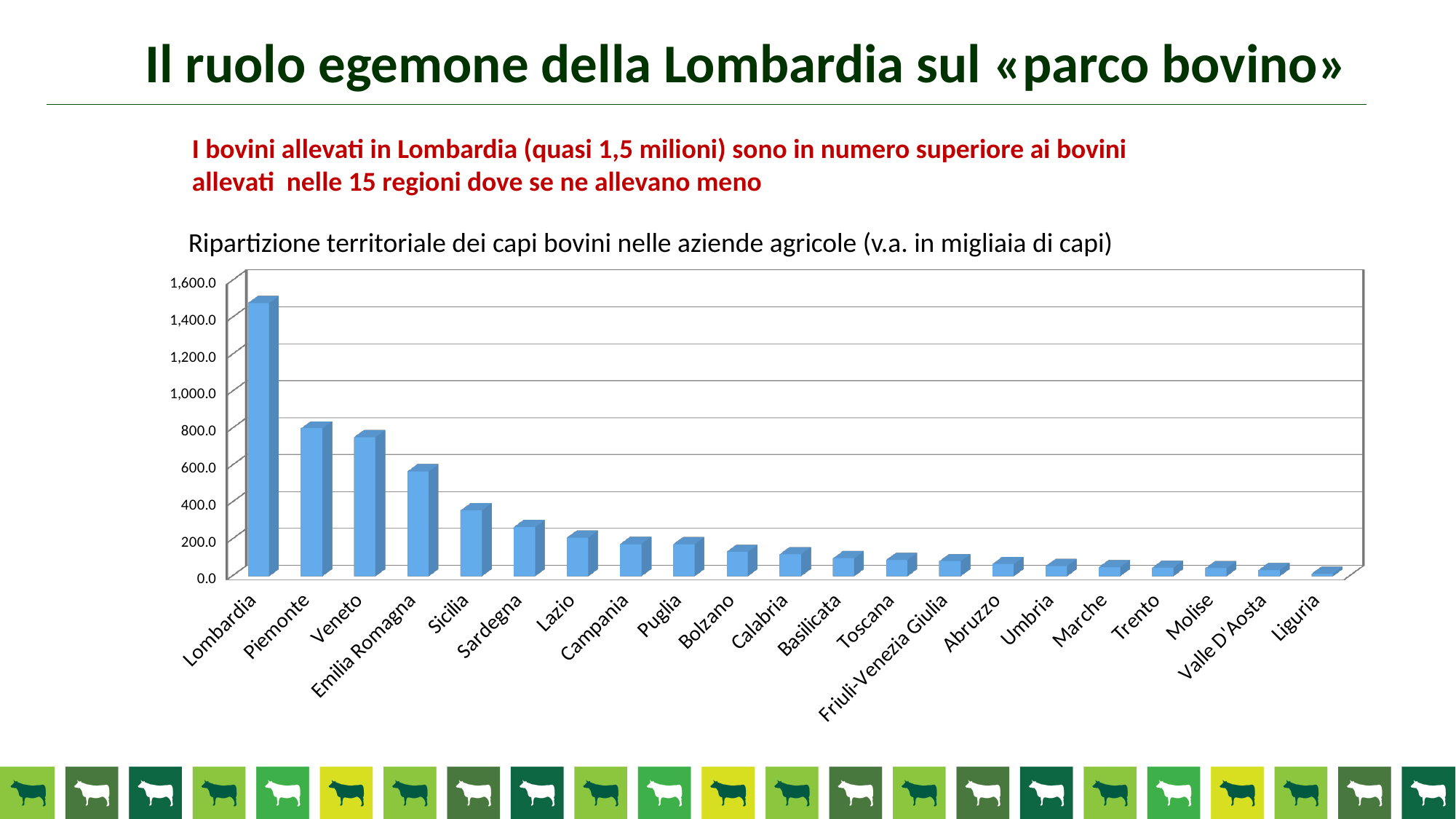
Which region has the lowest number of cattle in the chart? Liguria Is the value for Campania greater or less than 200.0? less What kind of chart is shown on the slide? bar chart Do the values rise or fall moving from left to right along the x axis? fall Is the value for Lombardia greater or less than 1,400.0? greater How many regions (categories) are shown on the x axis of the chart? 21 Is the value for Sicilia greater or less than 400.0? less What is the title of the chart? Ripartizione territoriale dei capi bovini nelle aziende agricole (v.a. in migliaia di capi) Which region has the highest number of cattle in the chart? Lombardia Which has a larger value, Veneto or Emilia Romagna? Veneto